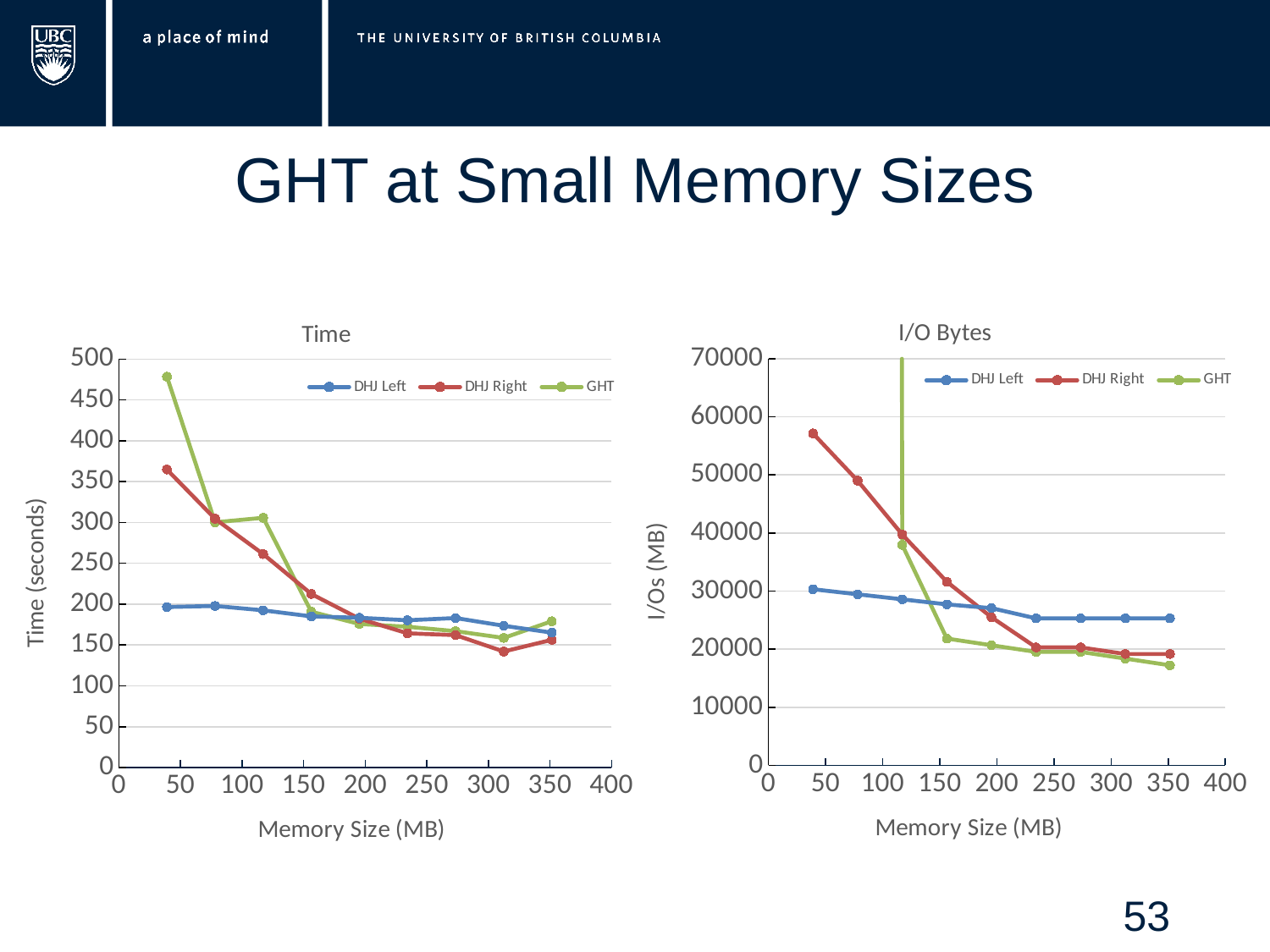
In the Time chart, is the DHJ Left value at the smallest memory size greater or less than 250 seconds? less In the Time chart, is the GHT value at the smallest memory size (about 40 MB) greater or less than 450 seconds? greater In the I/O Bytes chart, does the DHJ Right series rise or fall as memory size increases? fall In the I/O Bytes chart, is the DHJ Right value at the smallest memory size greater or less than 50000? greater In the Time chart, how many data points does the DHJ Left series have? 9 What kind of chart is the Time chart on the left? line chart In the Time chart, which series has the larger value at the smallest memory size, GHT or DHJ Left? GHT In the I/O Bytes chart, which series has the larger value at the largest memory size, DHJ Left or GHT? DHJ Left What is the y-axis label of the I/O Bytes chart? I/Os (MB) How many series does the legend of the I/O Bytes chart list? 3